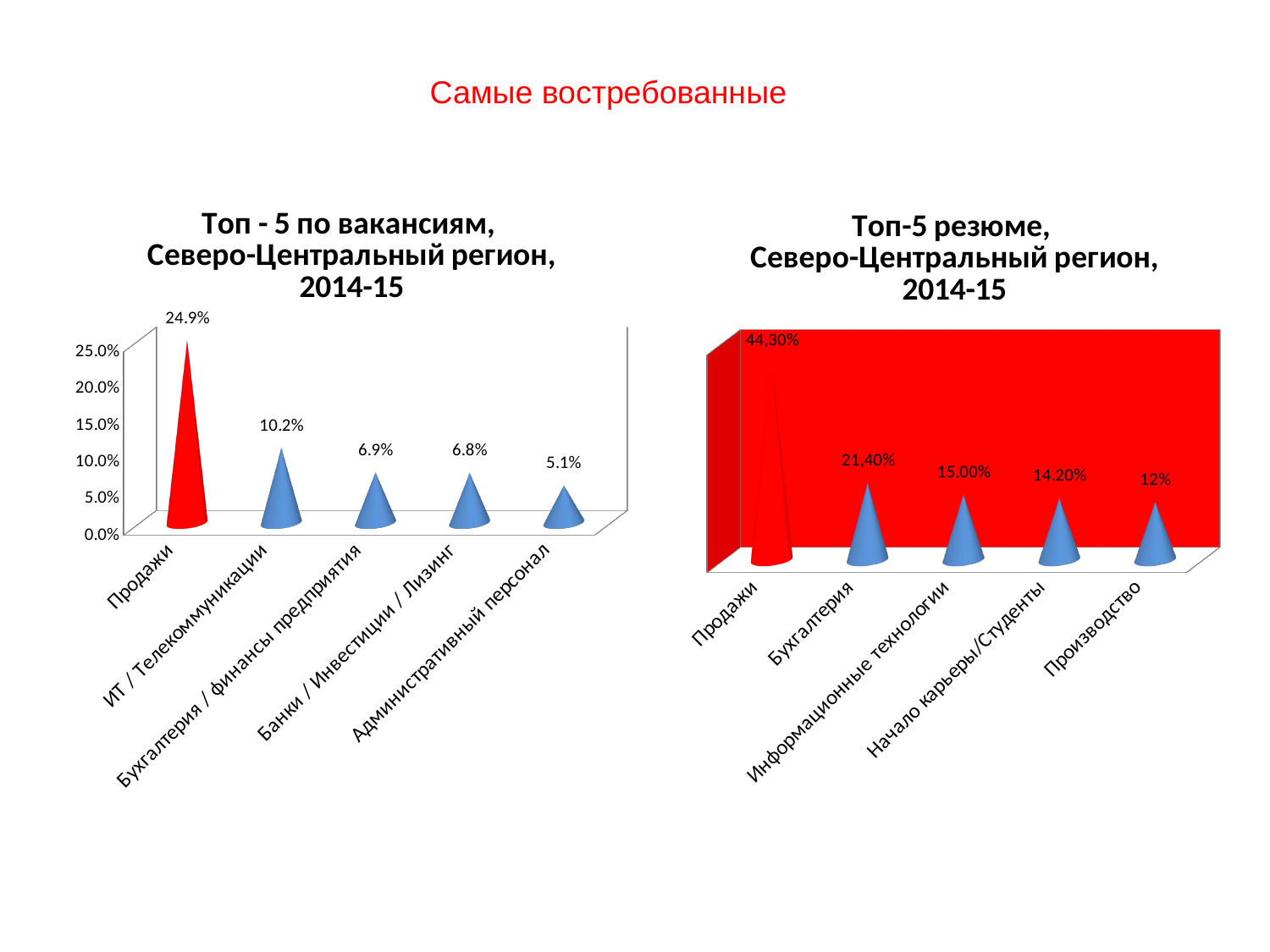
In the left chart (Топ - 5 по вакансиям), which category has the lowest value? Административный персонал In the right chart (Топ-5 резюме), what is the value for Информационные технологии? 15.00% In the right chart (Топ-5 резюме), which category has the highest value? Продажи In the right chart (Топ-5 резюме), which is larger: Бухгалтерия or Начало карьеры/Студенты? Бухгалтерия What kind of chart is the left chart (Топ - 5 по вакансиям)? bar chart In the left chart (Топ - 5 по вакансиям), what is the difference between Продажи and ИТ / Телекоммуникации? 14.7% In the left chart (Топ - 5 по вакансиям), do the values rise or fall from left to right along the x axis? fall In the left chart (Топ - 5 по вакансиям), what is the value for Продажи? 24.9% In the right chart (Топ-5 резюме), what is the value for Производство? 12% In the right chart (Топ-5 резюме), what is the value for Продажи? 44,30% In the left chart (Топ - 5 по вакансиям), how many categories are shown? 5 In the left chart (Топ - 5 по вакансиям), what is the value for ИТ / Телекоммуникации? 10.2%